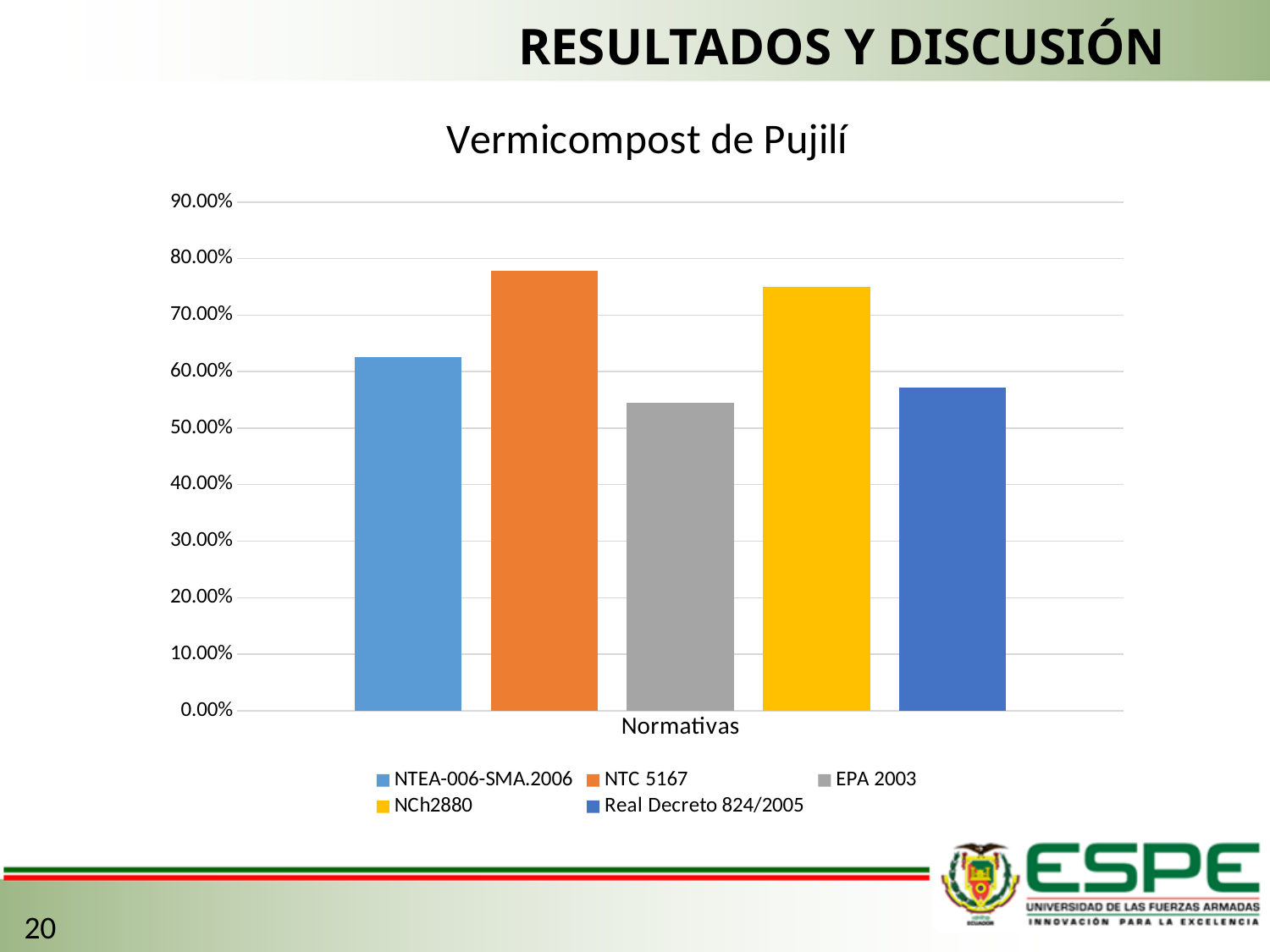
Is the value for Real Decreto 824/2005 greater or less than 60.00%? less What is the title of the chart? Vermicompost de Pujilí Is the value for EPA 2003 greater or less than 60.00%? less Is the value for NTEA-006-SMA.2006 greater or less than 60.00%? greater Which series has the lowest bar? EPA 2003 What kind of chart is shown on the slide? bar chart Which series has the highest bar? NTC 5167 How many series does the legend list? 5 What is the label on the x axis of the chart? Normativas Which is larger, the value for NTEA-006-SMA.2006 or the value for EPA 2003? NTEA-006-SMA.2006 Which is larger, the value for NCh2880 or the value for Real Decreto 824/2005? NCh2880